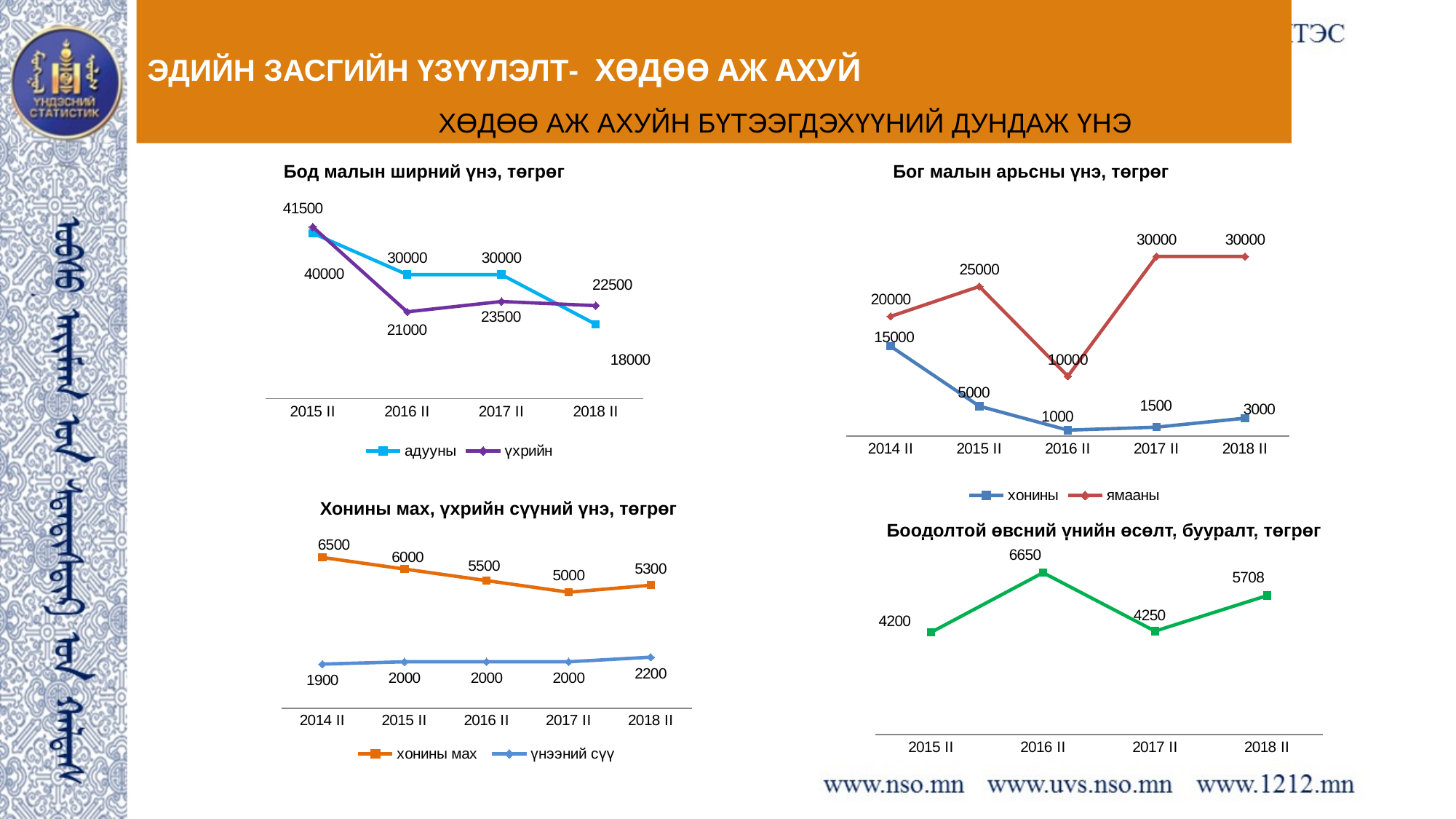
In the chart 'Бог малын арьсны үнэ, төгрөг', how many series does the legend list? 2 In the chart 'Хонины мах, үхрийн сүүний үнэ, төгрөг', how many periods are shown on the x axis? 5 In the chart 'Боодолтой өвсний үнийн өсөлт, бууралт, төгрөг', what is the difference between the 2018 II and 2017 II values? 1458 In the chart 'Боодолтой өвсний үнийн өсөлт, бууралт, төгрөг', which period has the highest value? 2016 II In the chart 'Бод малын ширний үнэ, төгрөг', what is the value for адууны in 2016 II? 30000 In the chart 'Бод малын ширний үнэ, төгрөг', what is the value for үхрийн in 2018 II? 22500 In the chart 'Бог малын арьсны үнэ, төгрөг', in which period is the хонины value lowest? 2016 II What kind of chart is 'Боодолтой өвсний үнийн өсөлт, бууралт, төгрөг'? line chart In the chart 'Бог малын арьсны үнэ, төгрөг', what is the value for ямааны in 2016 II? 10000 In the chart 'Хонины мах, үхрийн сүүний үнэ, төгрөг', what is the value for үнээний сүү in 2018 II? 2200 In the chart 'Хонины мах, үхрийн сүүний үнэ, төгрөг', what is the value for хонины мах in 2014 II? 6500 In the chart 'Бод малын ширний үнэ, төгрөг', what is the difference between адууны and үхрийн in 2016 II? 9000